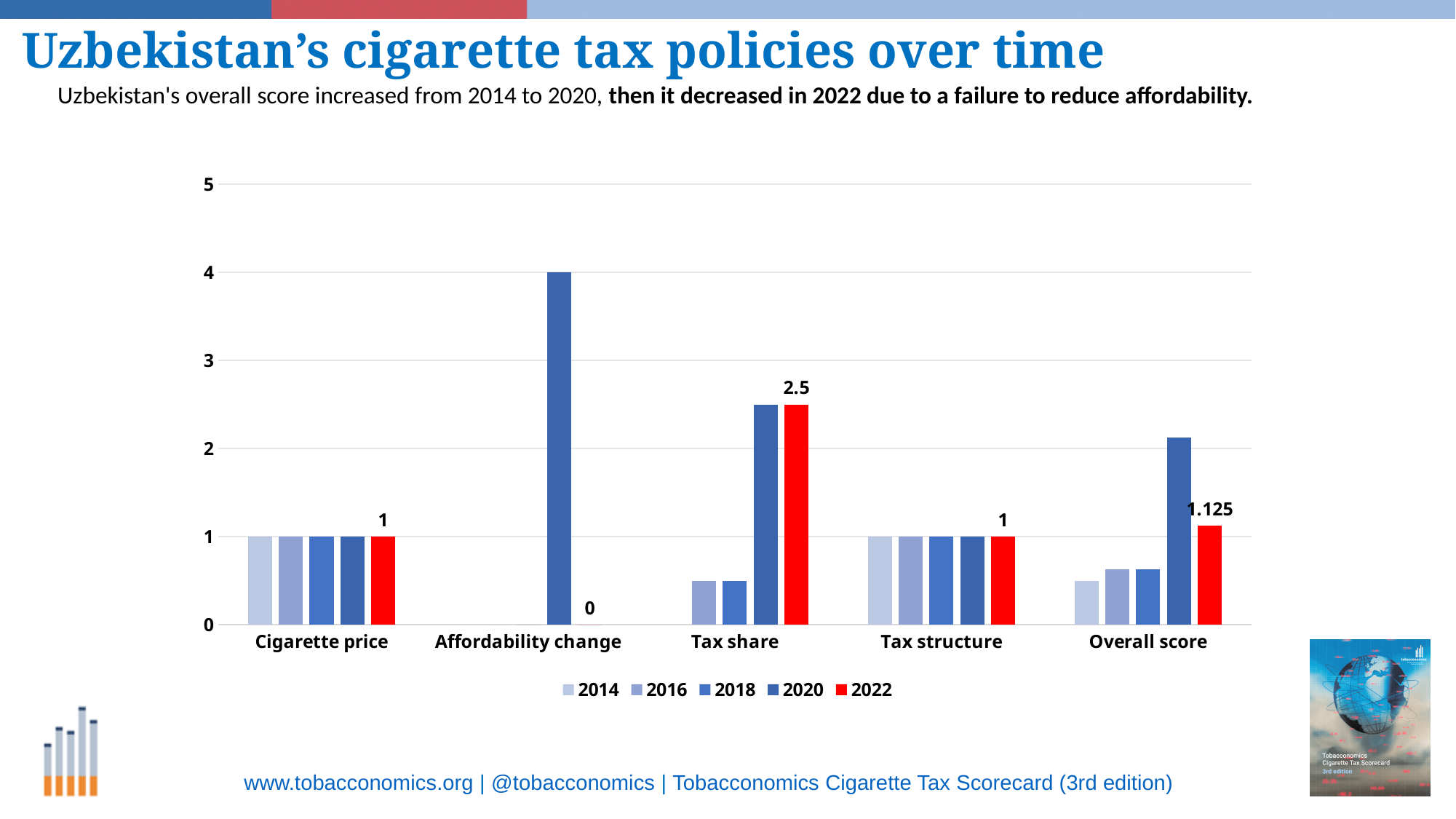
What is the 2020 value for Affordability change? 4 For Overall score, which is larger: the 2020 value or the 2022 value? 2020 Among the 2022 values, which category has the highest score? Tax share What is the 2022 value for Affordability change? 0 What is the 2022 value for Tax share? 2.5 What is the 2022 value for Overall score? 1.125 How many series does the legend list? 5 What kind of chart is shown on the slide? Bar chart How many categories are shown on the x axis? 5 Is the 2020 value for Overall score greater or less than 2? greater What is the difference between the 2022 Tax share value and the 2022 Overall score value? 1.375 What is the 2022 value for Cigarette price? 1